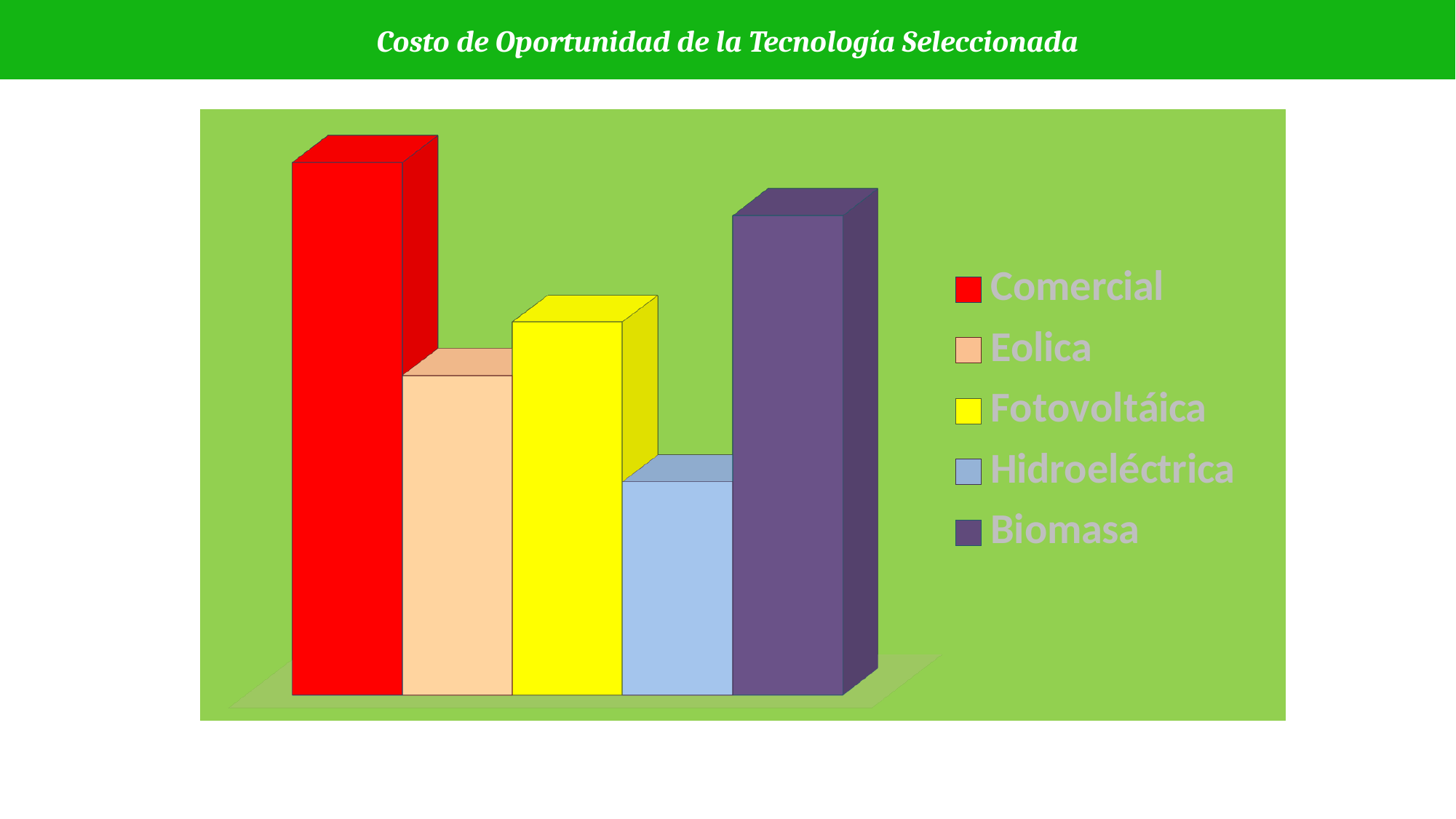
Which bar is taller, Fotovoltáica or Eolica? Fotovoltáica What colour is the Biomasa bar? Purple Which bar is taller, Comercial or Biomasa? Comercial Which category has the shortest bar in the chart? Hidroeléctrica Which category has the second tallest bar? Biomasa Which bar is taller, Biomasa or Fotovoltáica? Biomasa How many bars are plotted in the chart? 5 What is the title of the slide? Costo de Oportunidad de la Tecnología Seleccionada How many entries does the legend list? 5 What kind of chart is shown on the slide? Bar chart Which category has the tallest bar in the chart? Comercial